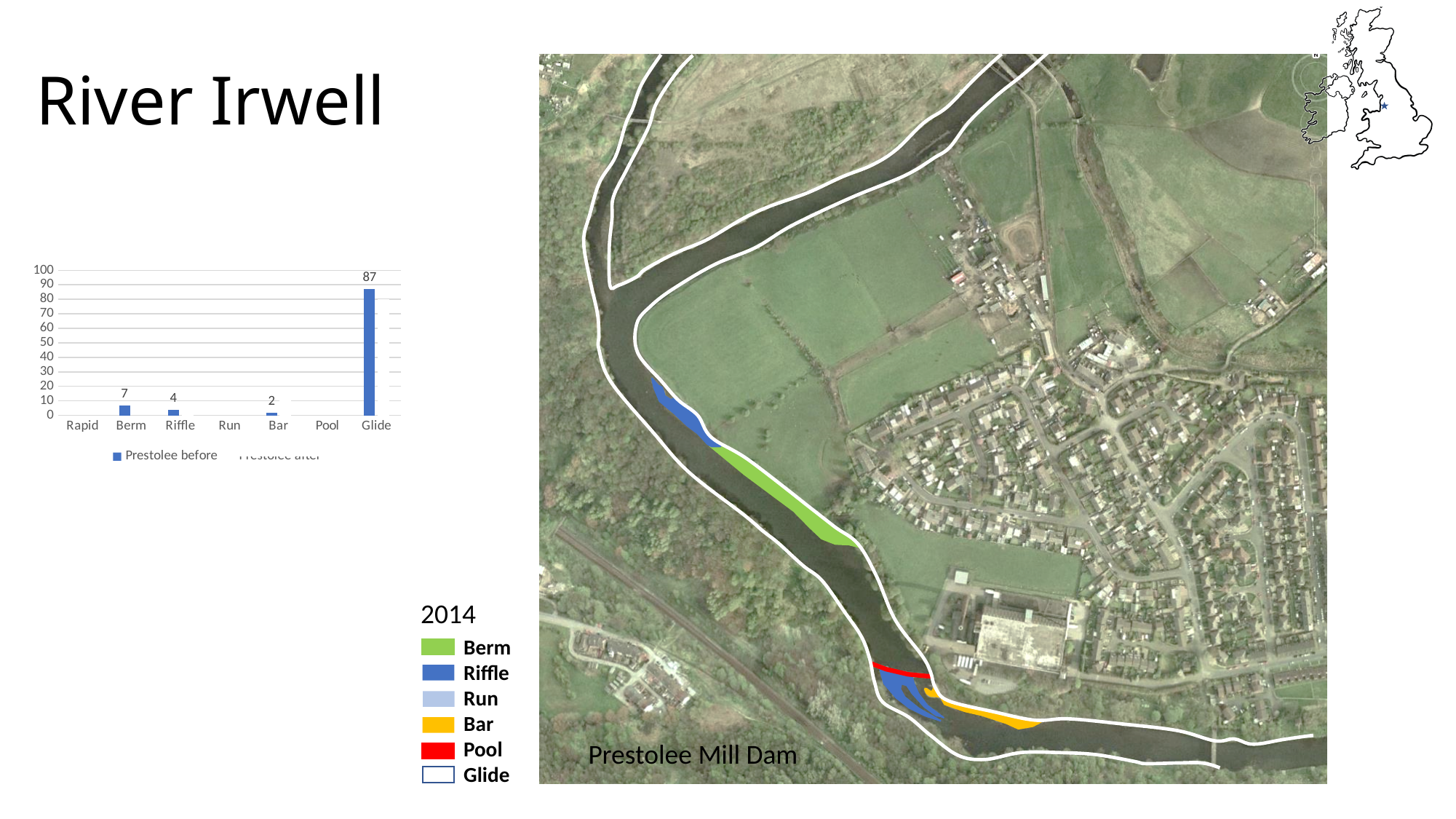
Is the value for Glide in the bar chart greater or less than 50? greater What is the value for Glide in the bar chart? 87 Which category has the highest value in the bar chart? Glide How many categories are shown on the x axis of the bar chart? 7 What is the value for Berm in the bar chart? 7 What kind of chart is shown on the slide? bar chart What is the difference between the values for Glide and Berm in the bar chart? 80 What is the difference between the values for Berm and Riffle in the bar chart? 3 What is the value for Bar in the bar chart? 2 Which is larger in the bar chart, the value for Berm or the value for Riffle? Berm What is the value for Riffle in the bar chart? 4 What is the first legend entry of the bar chart? Prestolee before